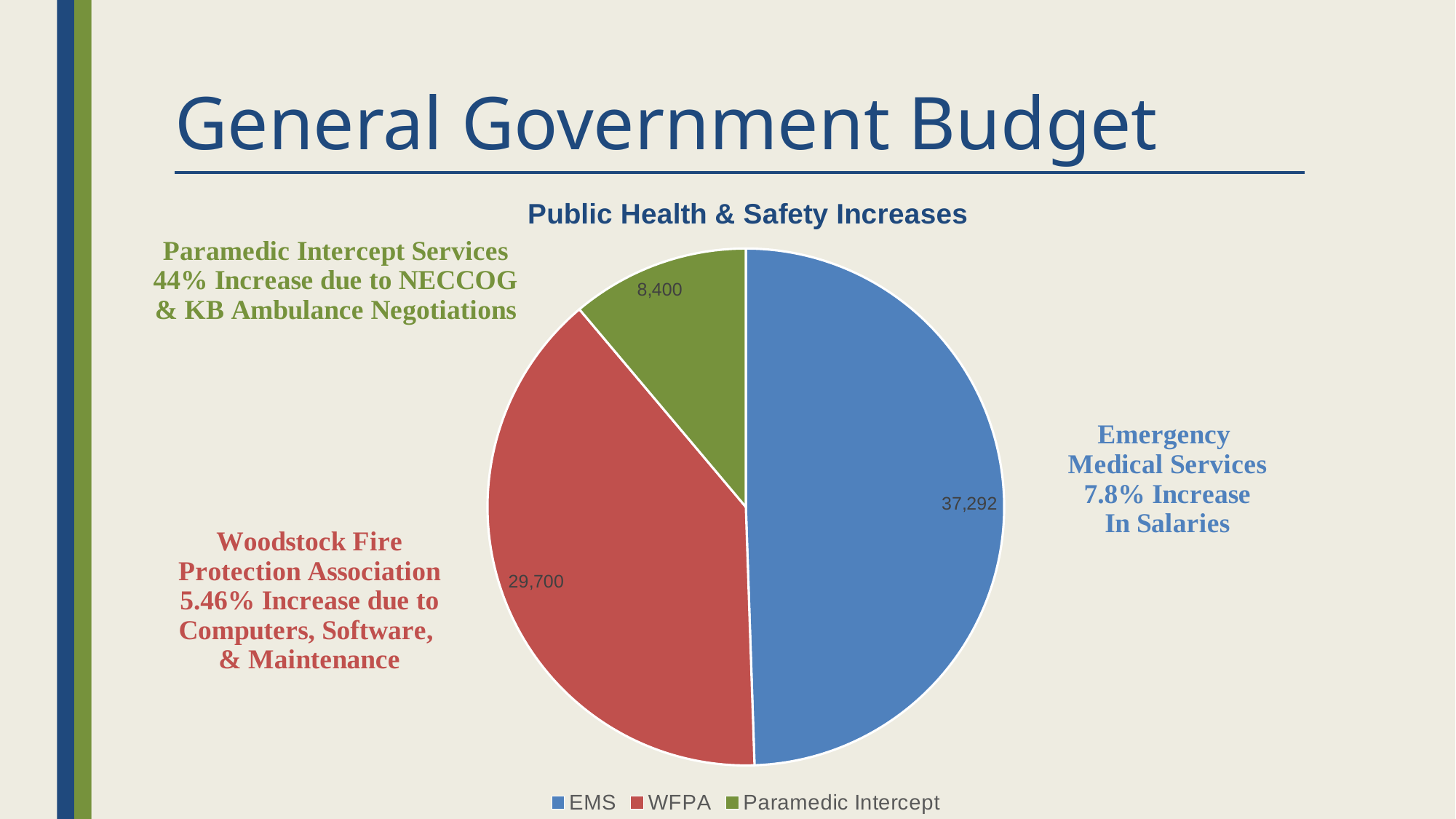
What is the title of the chart? Public Health & Safety Increases What colour is the WFPA slice in the pie chart? Red How many slices does the pie chart have? 3 Which is larger, the WFPA value or the Paramedic Intercept value? WFPA What is the value for EMS in the pie chart? 37,292 Which category has the smallest slice of the pie? Paramedic Intercept What is the value for Paramedic Intercept in the pie chart? 8,400 What type of chart is shown on the slide? Pie chart What is the difference between the EMS value and the WFPA value? 7,592 Which category has the largest slice of the pie? EMS What is the value for WFPA in the pie chart? 29,700 How many entries does the legend list? 3